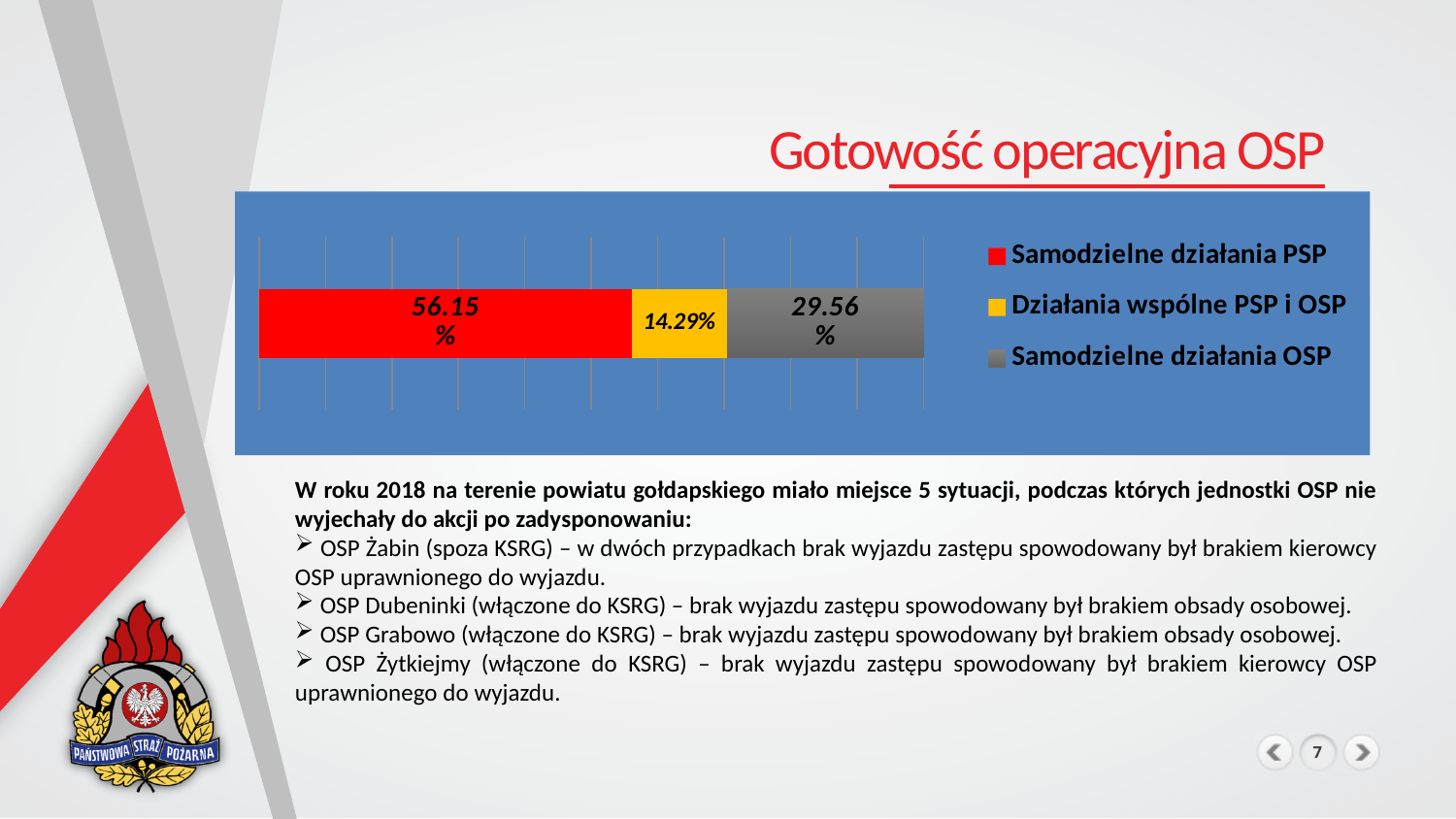
Which series has the smallest share of the bar? Działania wspólne PSP i OSP What kind of chart is shown on the slide? Stacked bar chart Which series has the largest share of the bar? Samodzielne działania PSP What percentage is shown for Samodzielne działania OSP? 29.56% Which is larger: Samodzielne działania OSP or Działania wspólne PSP i OSP? Samodzielne działania OSP What percentage is shown for Działania wspólne PSP i OSP? 14.29% What colour represents Działania wspólne PSP i OSP in the chart? Yellow What percentage is shown for Samodzielne działania PSP? 56.15% What is the difference between the Samodzielne działania PSP value and the Samodzielne działania OSP value? 26.59% What colour represents Samodzielne działania PSP in the chart? Red How many series does the legend list? 3 What is the total of the three segments in the stacked bar? 100%